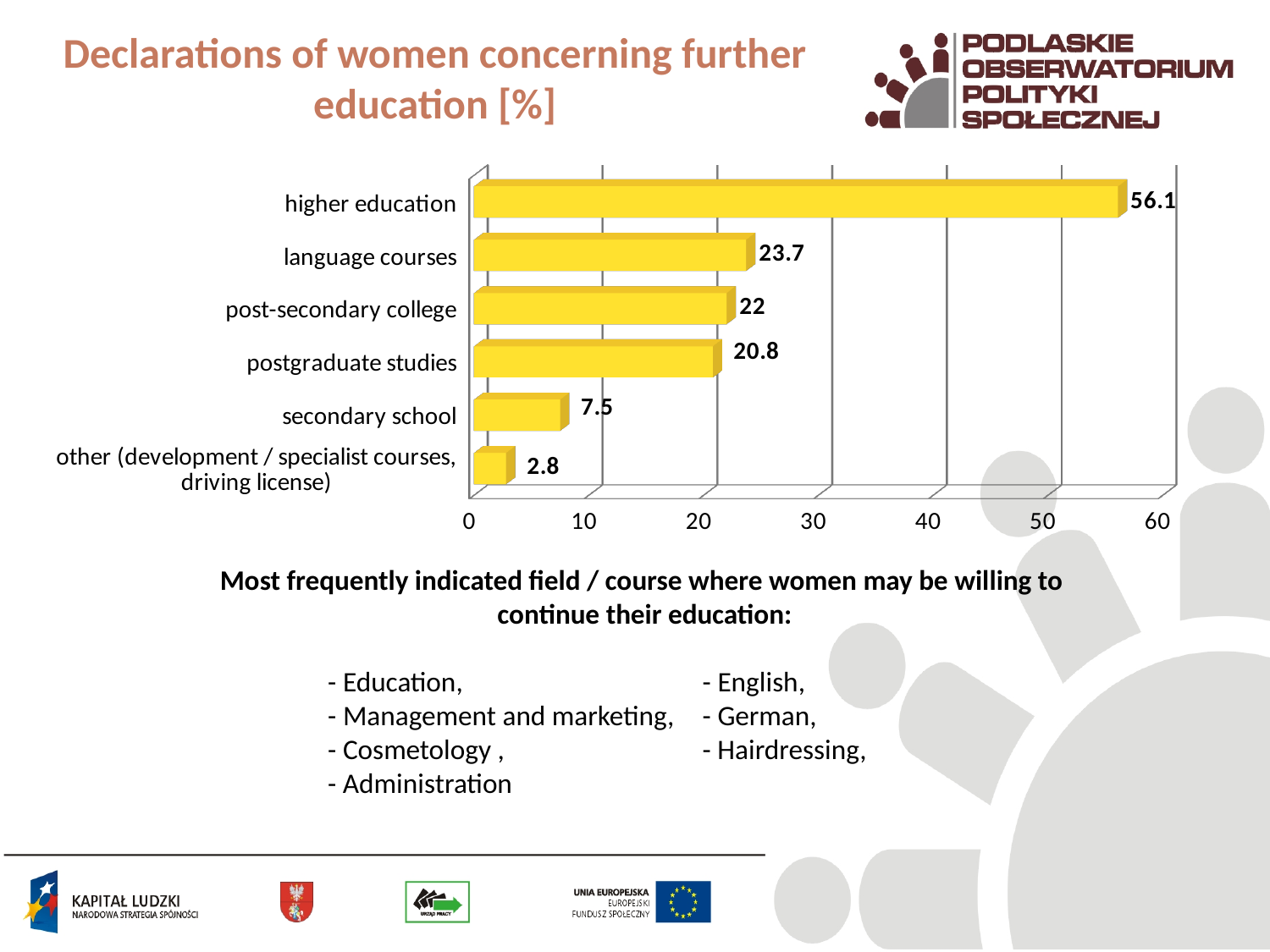
What is the value for postgraduate studies? 20.8 What kind of chart is shown on the slide? bar chart How many categories are shown in the chart? 6 What is the difference between the values for post-secondary college and secondary school? 14.5 Which category has the lowest value? other (development / specialist courses, driving license) What is the value for language courses? 23.7 Is the value for post-secondary college greater or less than 30? less Which category has the highest value? higher education What is the value for higher education? 56.1 What is the value for secondary school? 7.5 Which is larger, the value for language courses or the value for postgraduate studies? language courses What is the difference between the values for higher education and language courses? 32.4